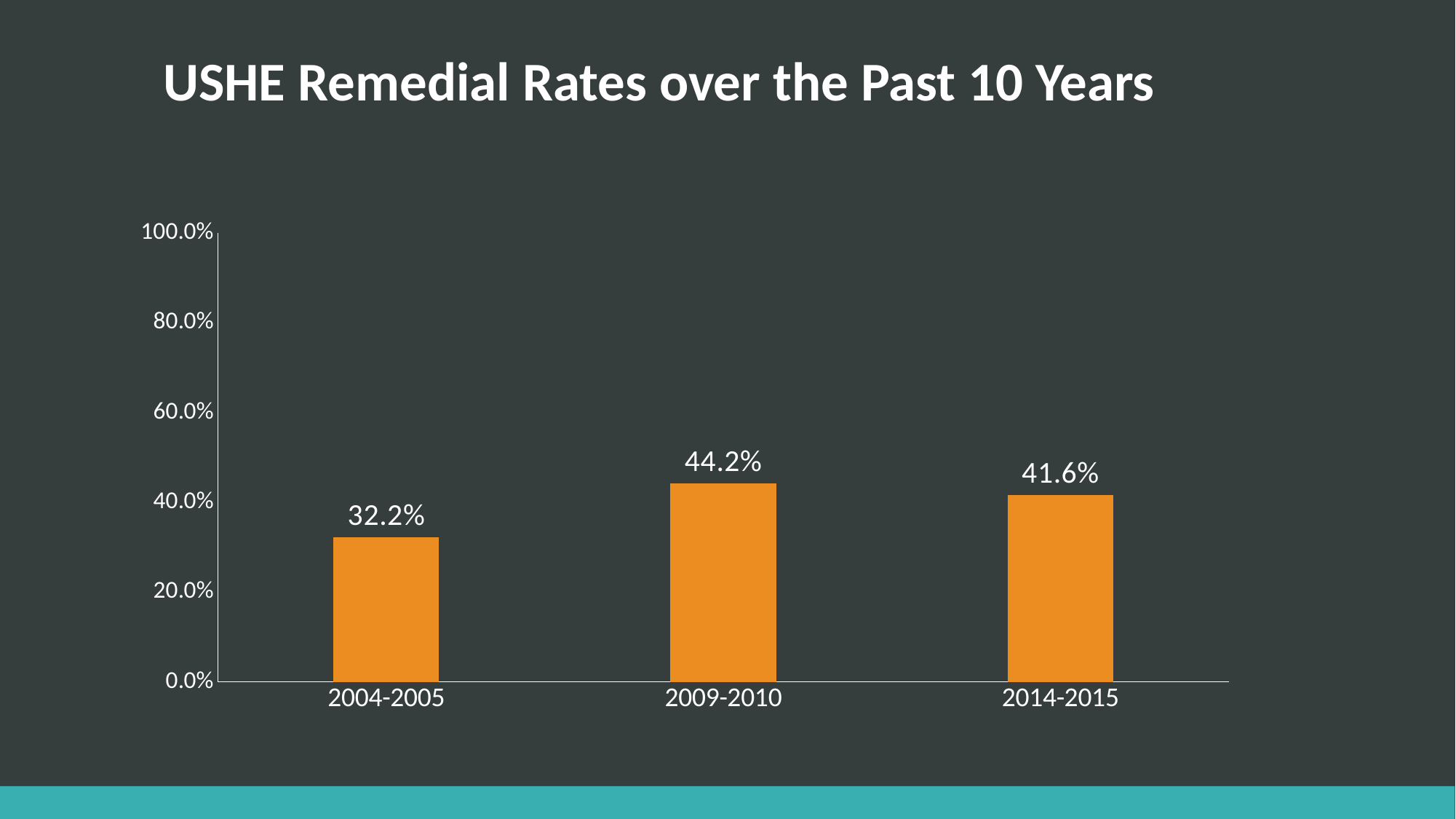
Which period has the lowest remedial rate? 2004-2005 What is the remedial rate for 2004-2005? 32.2% What is the remedial rate for 2009-2010? 44.2% What is the difference between the remedial rates for 2009-2010 and 2004-2005? 12.0% How many periods are shown on the chart? 3 What is the difference between the remedial rates for 2009-2010 and 2014-2015? 2.6% What is the title of the chart? USHE Remedial Rates over the Past 10 Years Which is larger, the remedial rate for 2014-2015 or for 2004-2005? 2014-2015 What is the remedial rate for 2014-2015? 41.6% What kind of chart is shown on the slide? Bar chart Is the value for 2009-2010 greater or less than 40.0%? greater Which period has the highest remedial rate? 2009-2010